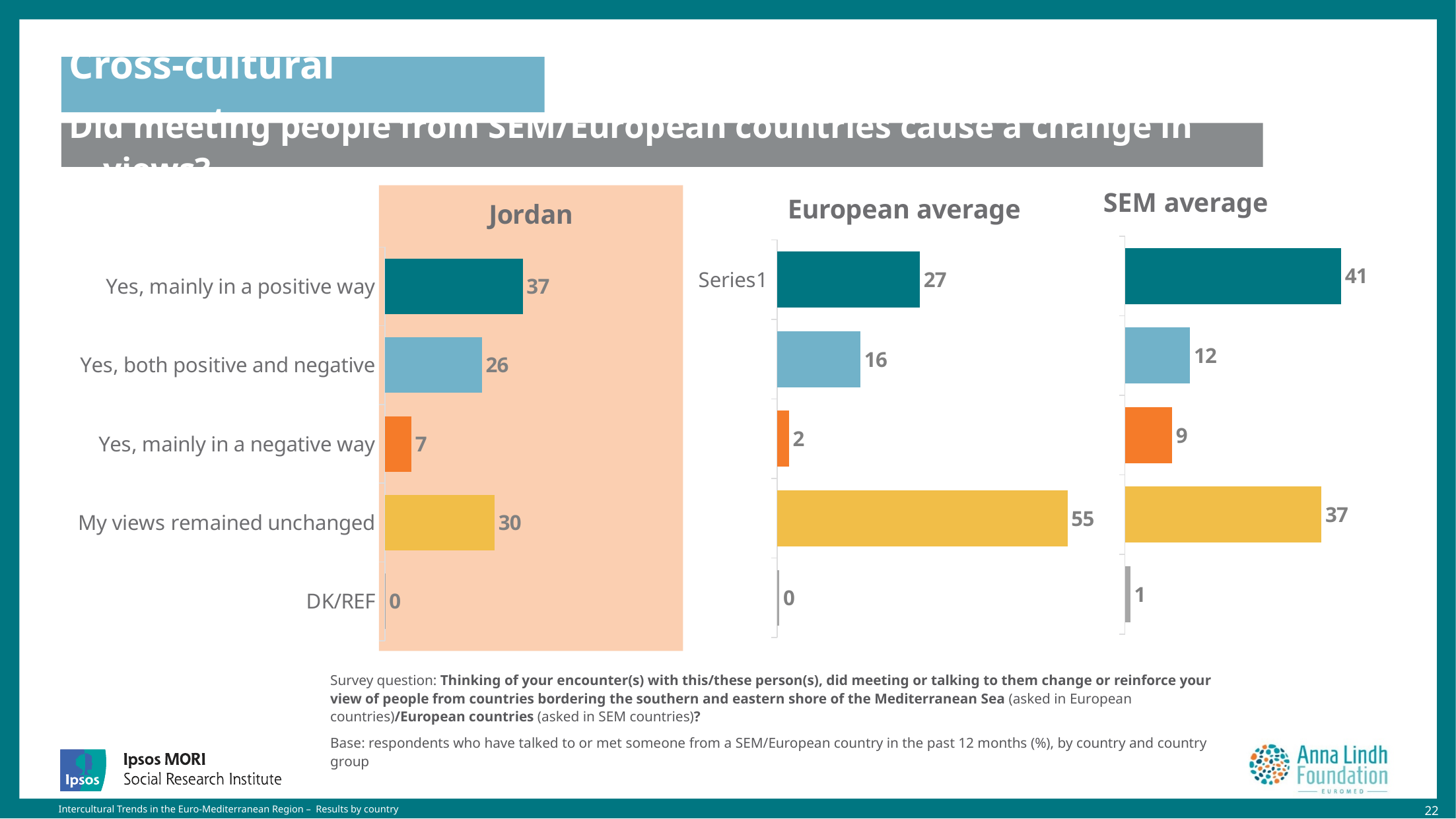
In the Jordan chart, what is the value for "Yes, mainly in a positive way"? 37 In the Jordan chart, which category has the lowest value? DK/REF In the European average chart, which category has the highest value? My views remained unchanged In the European average chart, what is the value for "My views remained unchanged"? 55 How many categories are shown in the Jordan chart? 5 In the SEM average chart, what is the difference between "Yes, mainly in a positive way" and "My views remained unchanged"? 4 In the SEM average chart, what is the value for "Yes, both positive and negative"? 12 What type of chart is the Jordan chart? Bar chart Which is larger: "Yes, mainly in a negative way" in the SEM average chart or in the European average chart? SEM average In the Jordan chart, what is the difference between "Yes, mainly in a positive way" and "My views remained unchanged"? 7 In the European average chart, what is the value for DK/REF? 0 In the SEM average chart, which category has the highest value? Yes, mainly in a positive way